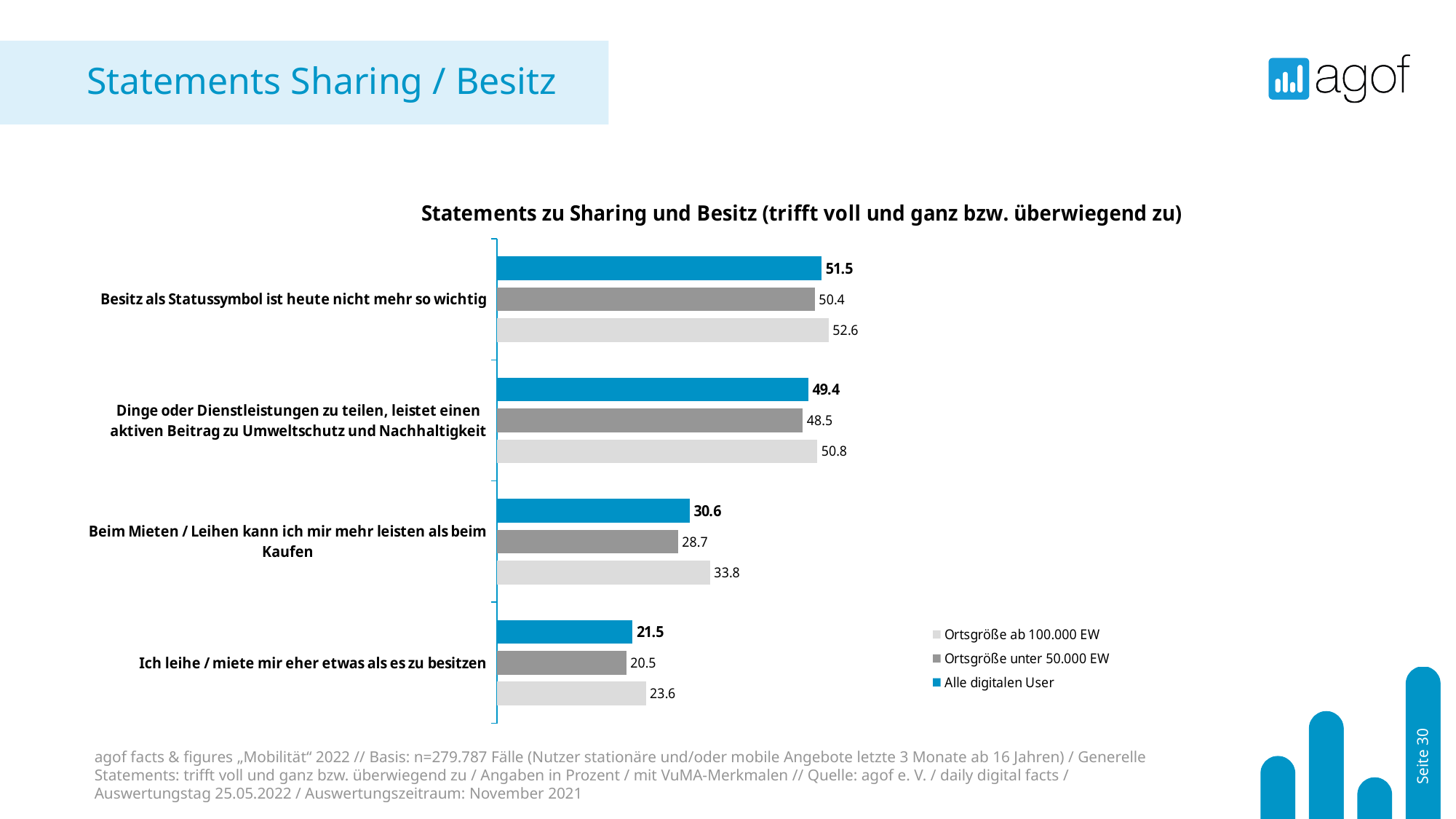
What is the difference between the "Ortsgröße ab 100.000 EW" and "Ortsgröße unter 50.000 EW" values for "Beim Mieten / Leihen kann ich mir mehr leisten als beim Kaufen"? 5.1 How many series does the legend list? 3 Which statement has the lowest value for "Ortsgröße unter 50.000 EW"? Ich leihe / miete mir eher etwas als es zu besitzen What is the value for "Ortsgröße ab 100.000 EW" for the statement "Ich leihe / miete mir eher etwas als es zu besitzen"? 23.6 For the statement "Dinge oder Dienstleistungen zu teilen, leistet einen aktiven Beitrag zu Umweltschutz und Nachhaltigkeit", which series has the larger value: "Ortsgröße ab 100.000 EW" or "Ortsgröße unter 50.000 EW"? Ortsgröße ab 100.000 EW What kind of chart is shown on the slide? Bar chart What is the value for "Alle digitalen User" for the statement "Besitz als Statussymbol ist heute nicht mehr so wichtig"? 51.5 Which statement has the highest value for "Alle digitalen User"? Besitz als Statussymbol ist heute nicht mehr so wichtig Which series is shown in blue? Alle digitalen User What is the title of the chart? Statements zu Sharing und Besitz (trifft voll und ganz bzw. überwiegend zu) What is the value for "Ortsgröße unter 50.000 EW" for the statement "Beim Mieten / Leihen kann ich mir mehr leisten als beim Kaufen"? 28.7 How many statements are shown in the chart? 4